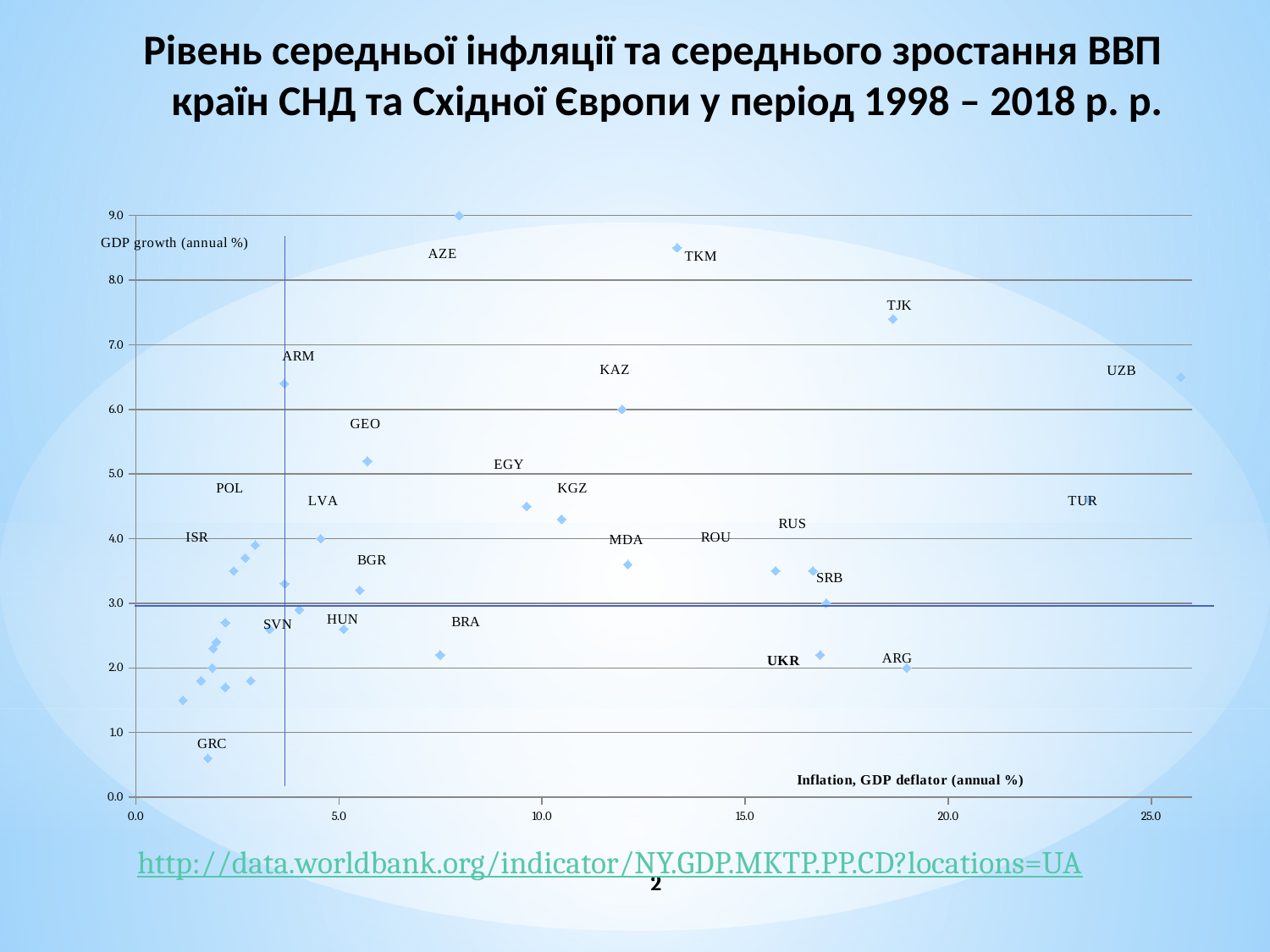
Is the GDP growth value for UKR greater or less than 3.0? less Which labelled country has the lowest GDP growth on the chart? GRC What is the label of the horizontal axis of the chart? Inflation, GDP deflator (annual %) Which labelled country has the highest GDP growth on the chart? AZE What kind of chart is shown on the slide? scatter chart Is the GDP growth value for GRC greater or less than 1.0? less Is the inflation value for UZB greater or less than 20.0? greater Which has the higher inflation value, TJK or UZB? UZB What is the label of the vertical axis of the chart? GDP growth (annual %)